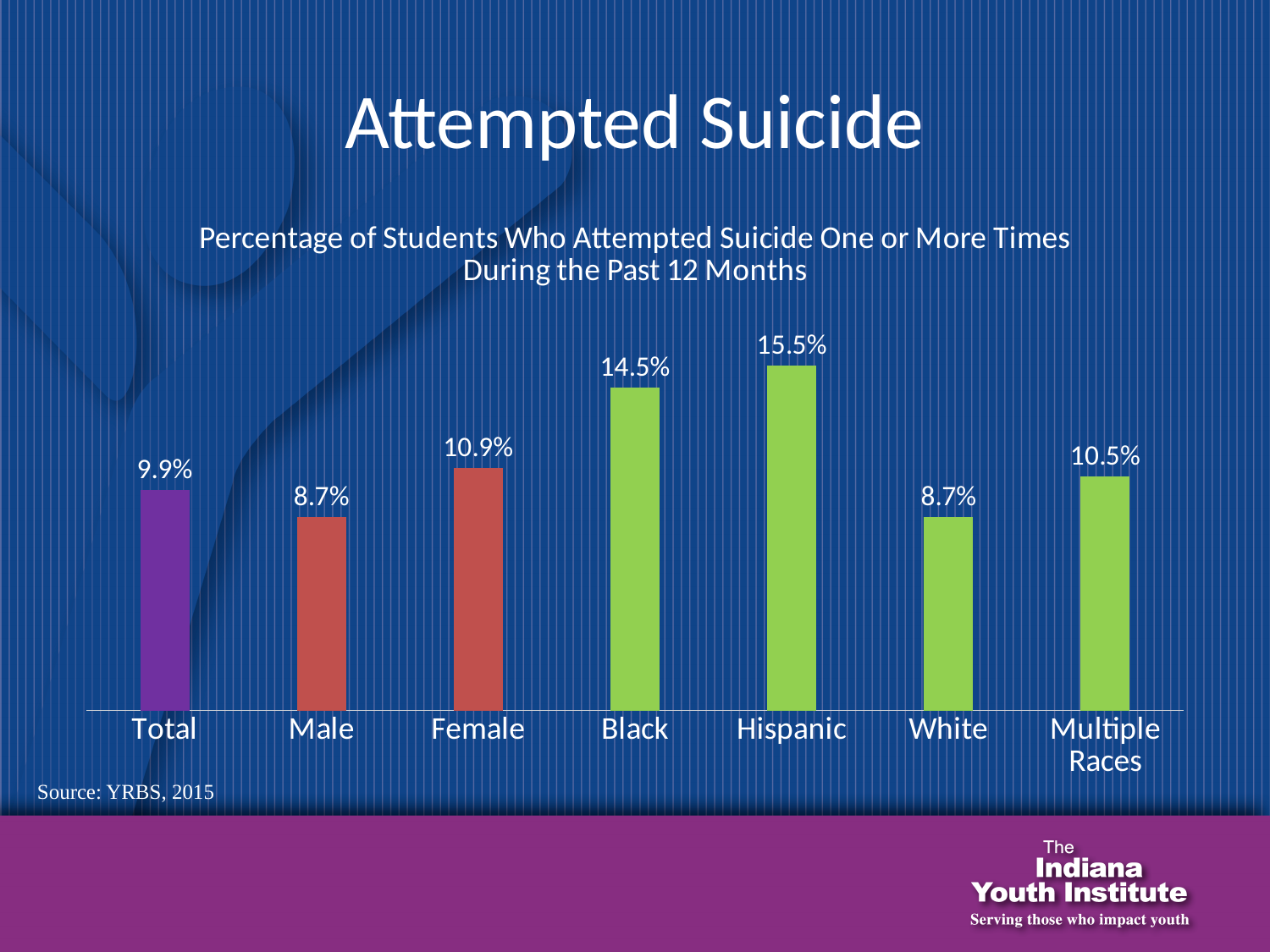
How many categories are shown on the x axis? 7 Which is larger, the value for Black or the value for White? Black Which category has the highest percentage? Hispanic What is the value for Female students? 10.9% What is the value for Multiple Races? 10.5% What is the value for Hispanic students? 15.5% What is the title of the chart? Percentage of Students Who Attempted Suicide One or More Times During the Past 12 Months What is the value for the Total category? 9.9% Which is larger, the value for Female or the value for Multiple Races? Female What kind of chart is shown on the slide? Bar chart What is the difference between the Female and Male percentages? 2.2% What is the difference between the Hispanic and Black percentages? 1.0%